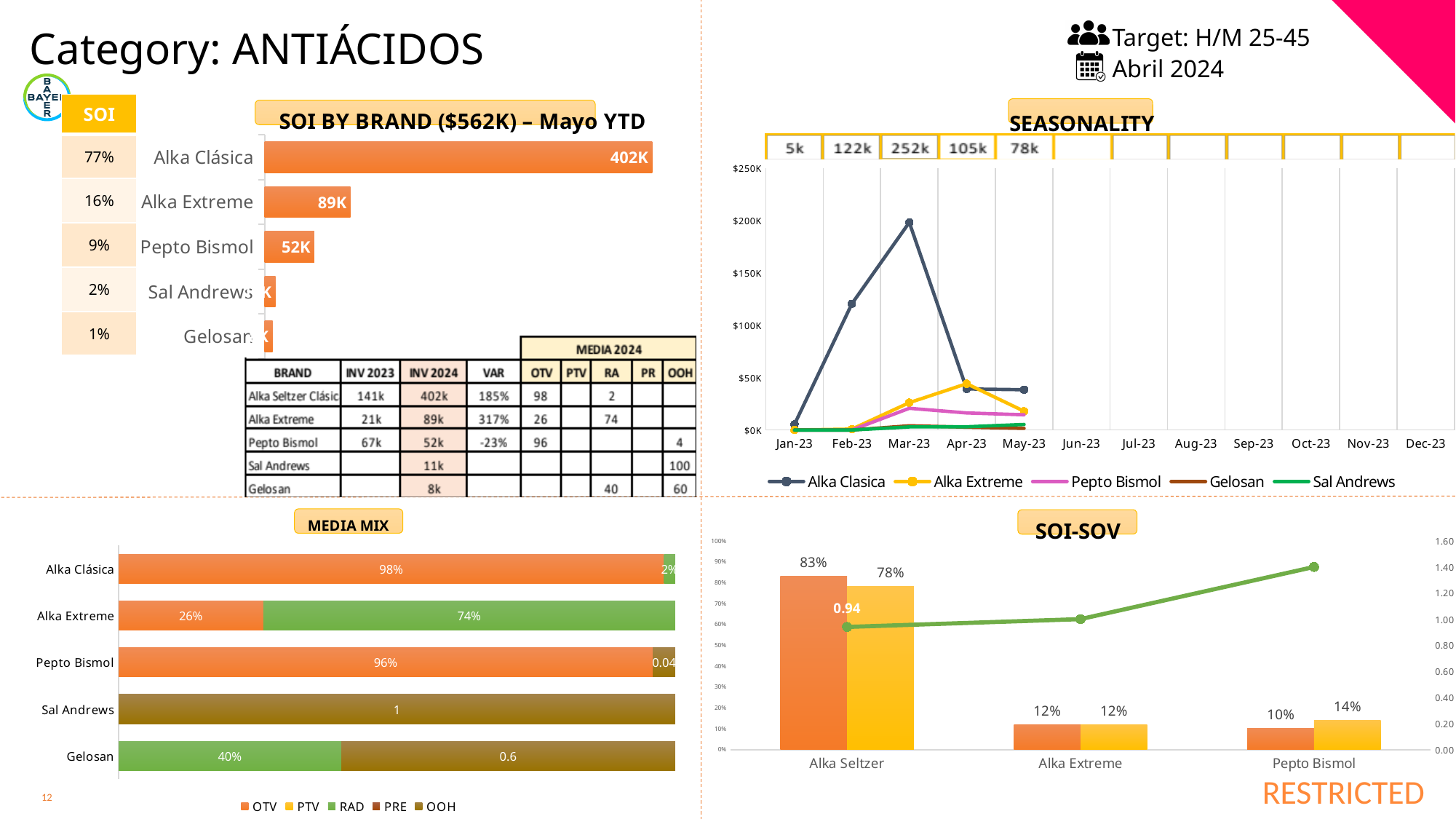
In the SEASONALITY chart, is the value for Alka Clasica in Mar-23 greater or less than $150K? greater What kind of chart is the SEASONALITY chart? line chart How many series does the legend of the SEASONALITY chart list? 5 In the MEDIA MIX chart, what is the RAD share for Alka Extreme? 74% In the SOI-SOV chart, what is the second (yellow) bar value for Pepto Bismol? 14% In the MEDIA MIX chart, what is the OTV share for Pepto Bismol? 96% In the SOI-SOV chart, how many brands are shown on the x axis? 3 In the SOI BY BRAND chart, what is the value for Alka Clásica? 402K In the SEASONALITY chart, in which month does Alka Clasica reach its highest value? Mar-23 In the SOI BY BRAND chart, what is the value for Pepto Bismol? 52K In the SOI BY BRAND chart, what is the difference between Alka Clásica and Alka Extreme? 313K In the SOI BY BRAND chart, which brand has the highest value? Alka Clásica